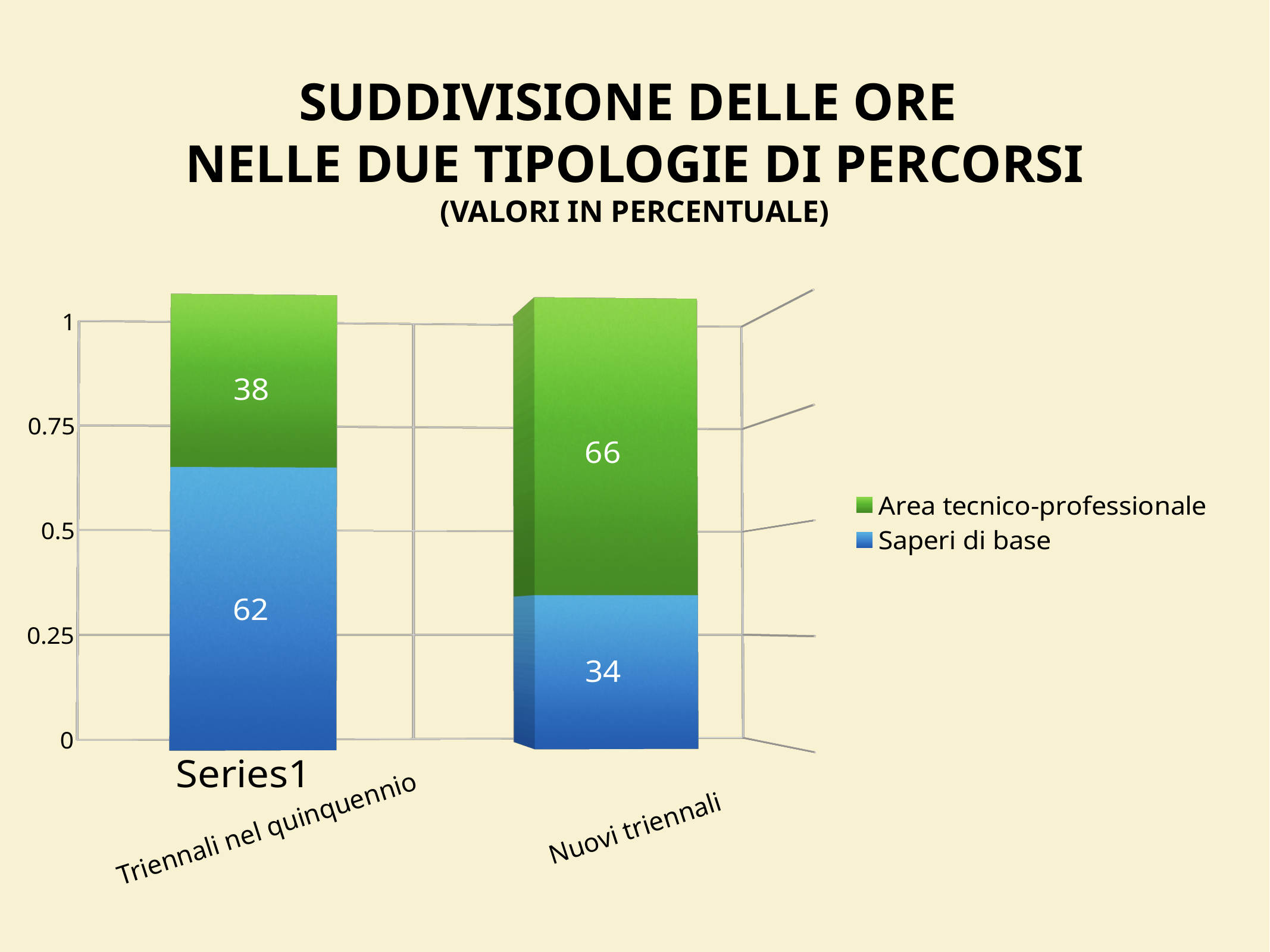
How many categories are shown on the x axis? 2 Is the Area tecnico-professionale value larger for Triennali nel quinquennio or for Nuovi triennali? Nuovi triennali What is the value of Saperi di base for Nuovi triennali? 34 What is the value of Area tecnico-professionale for Triennali nel quinquennio? 38 What is the difference between the Saperi di base values for Triennali nel quinquennio and Nuovi triennali? 28 What is the value of Area tecnico-professionale for Nuovi triennali? 66 What is the value of Saperi di base for Triennali nel quinquennio? 62 Which category has the higher value for Saperi di base? Triennali nel quinquennio How many series does the legend list? 2 Which colour represents Saperi di base in the legend? Blue Which category has the lower value for Area tecnico-professionale? Triennali nel quinquennio What kind of chart is shown on the slide? Stacked bar chart